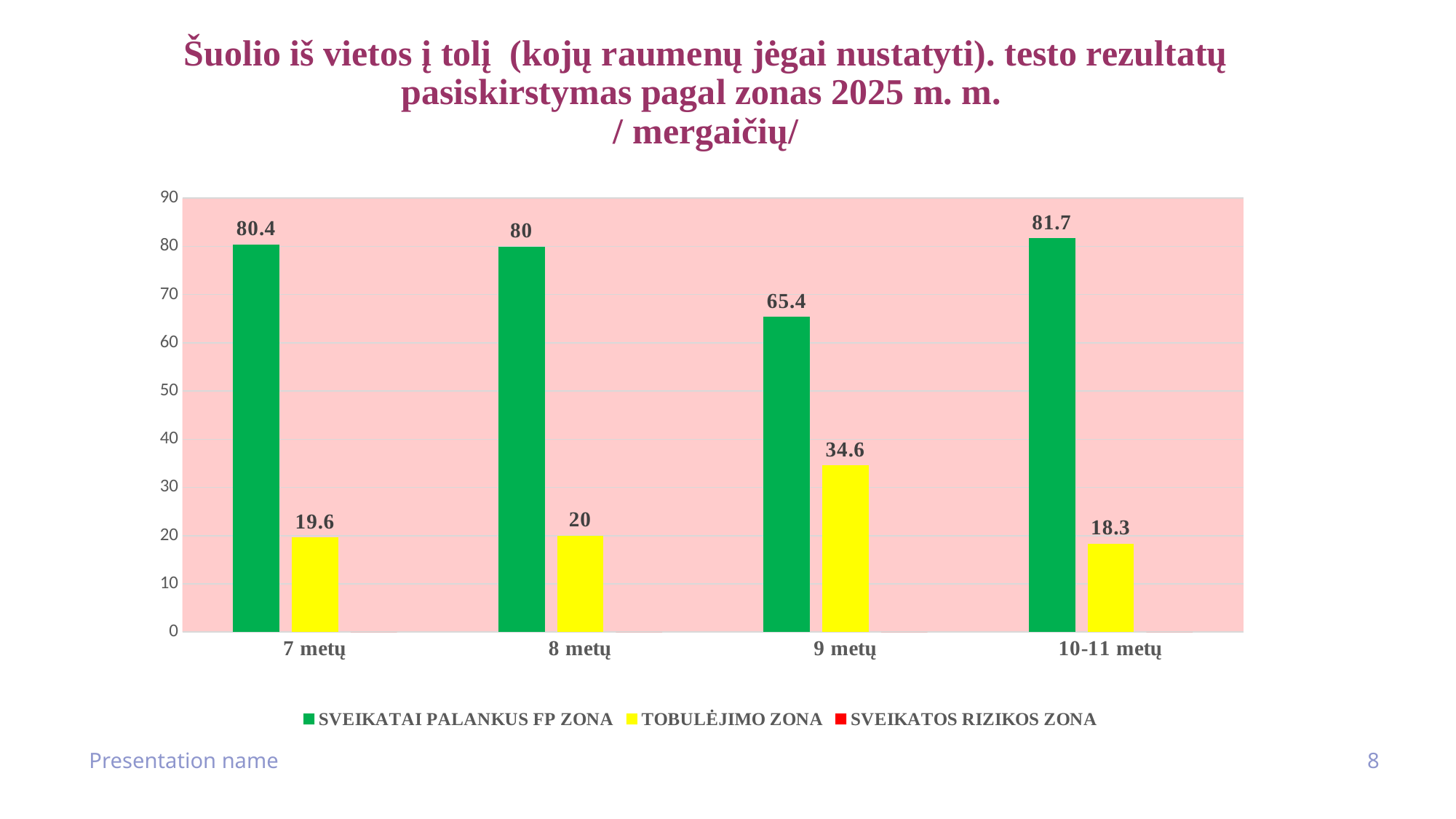
What colour are the TOBULĖJIMO ZONA bars? yellow What is the difference between the SVEIKATAI PALANKUS FP ZONA and TOBULĖJIMO ZONA values for 9 metų? 30.8 Is the SVEIKATAI PALANKUS FP ZONA value for 8 metų greater or less than 70? greater How many age groups are shown on the x axis? 4 What is the value for SVEIKATAI PALANKUS FP ZONA for 9 metų? 65.4 Which age group has the highest value for SVEIKATAI PALANKUS FP ZONA? 10-11 metų What is the value for TOBULĖJIMO ZONA for 8 metų? 20 What is the value for TOBULĖJIMO ZONA for 10-11 metų? 18.3 What kind of chart is shown on the slide? bar chart How many series does the legend list? 3 Which age group has the lowest value for TOBULĖJIMO ZONA? 10-11 metų Which is larger: the TOBULĖJIMO ZONA value for 7 metų or for 9 metų? 9 metų